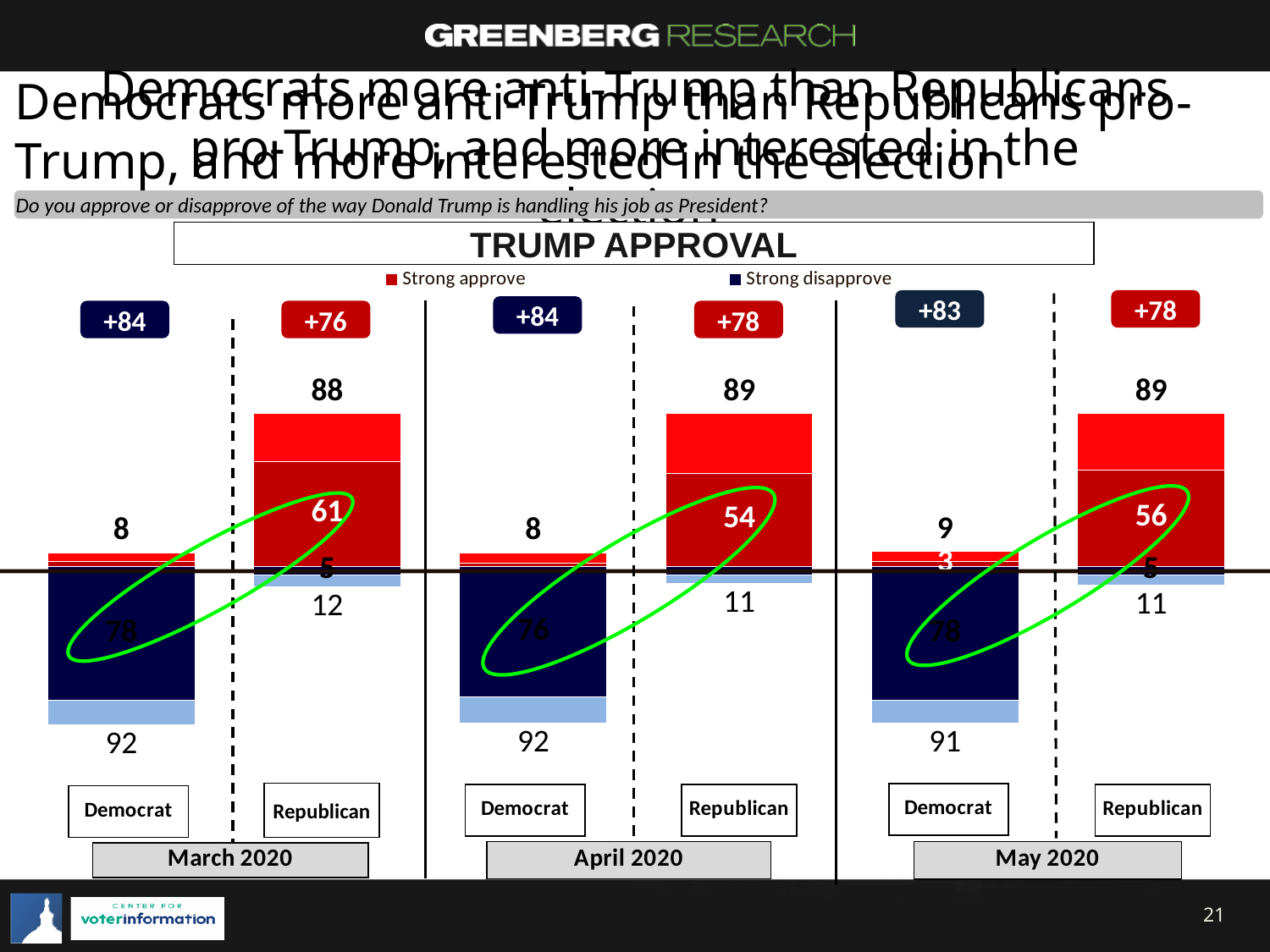
What is the strong disapprove value shown for Democrats in April 2020? 76 How many series does the legend list? 2 What net figure is shown in the box above the Republican bar in April 2020? +78 What is the title of the chart? TRUMP APPROVAL What is the total disapproval value shown for Democrats in May 2020? 91 Which is larger: the Democrat strong disapprove value in March 2020 or in April 2020? March 2020 What is the total approval value shown for Republicans in March 2020? 88 What is the strong approve value shown for Republicans in May 2020? 56 In which month is the Republican strong approve value highest? March 2020 What net figure is shown in the box above the Democrat bar in May 2020? +83 What is the difference between the Republican strong approve values in March 2020 and April 2020? 7 What kind of chart is shown on the slide? Bar chart